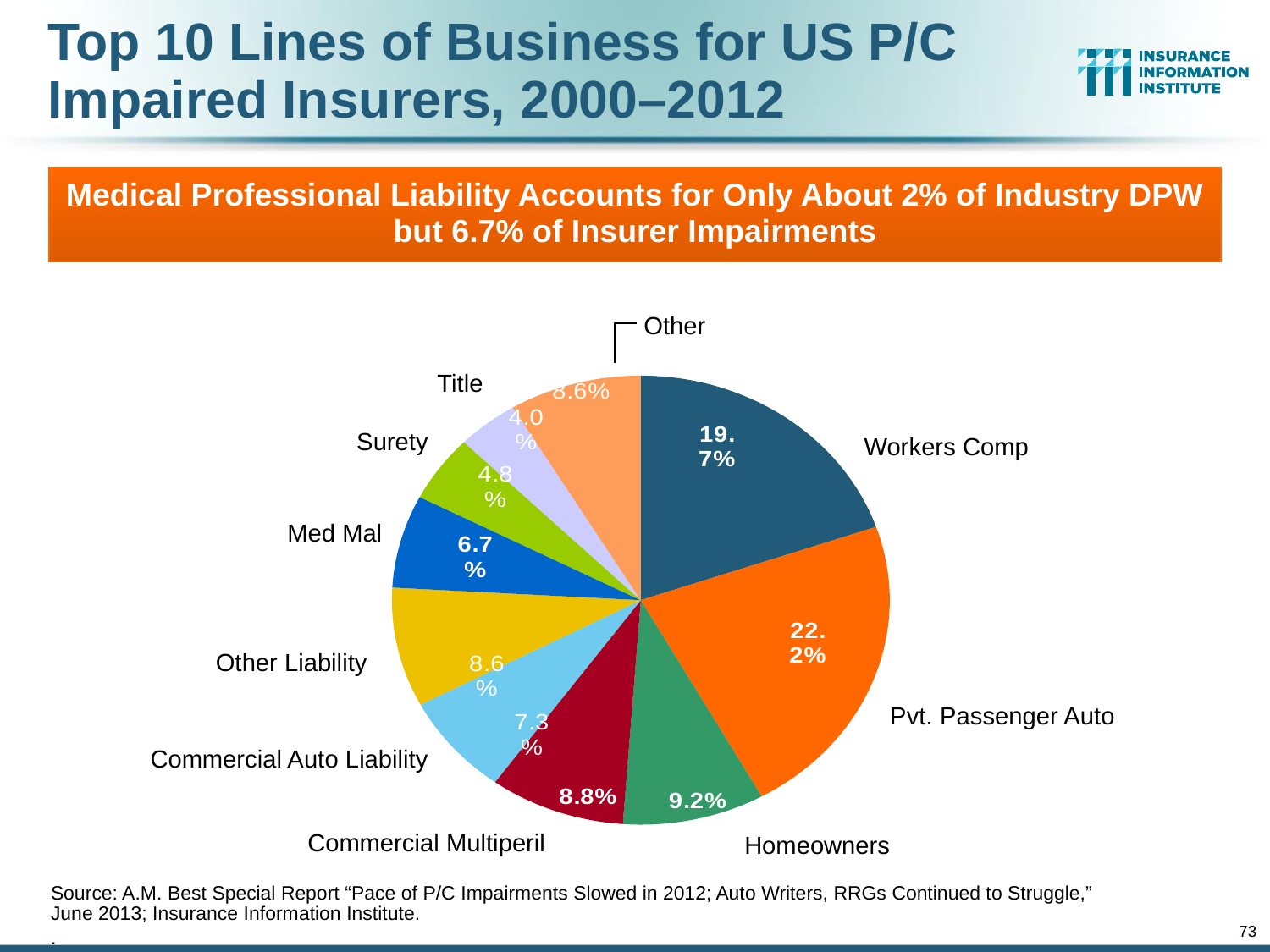
What is the difference between the Pvt. Passenger Auto and Workers Comp shares? 2.5% What is the value shown for Med Mal? 6.7% Which line of business has the largest slice of the pie? Pvt. Passenger Auto How many slices does the pie chart have? 10 What is the difference between the Surety and Title shares? 0.8% What type of chart is shown on the slide? Pie chart What share of impairments does Pvt. Passenger Auto account for? 22.2% What is the value shown for Homeowners? 9.2% What share of impairments does Workers Comp account for? 19.7% Which line of business has the smallest slice of the pie? Title Which is larger, the Homeowners slice or the Commercial Multiperil slice? Homeowners What is the value shown for Commercial Auto Liability? 7.3%